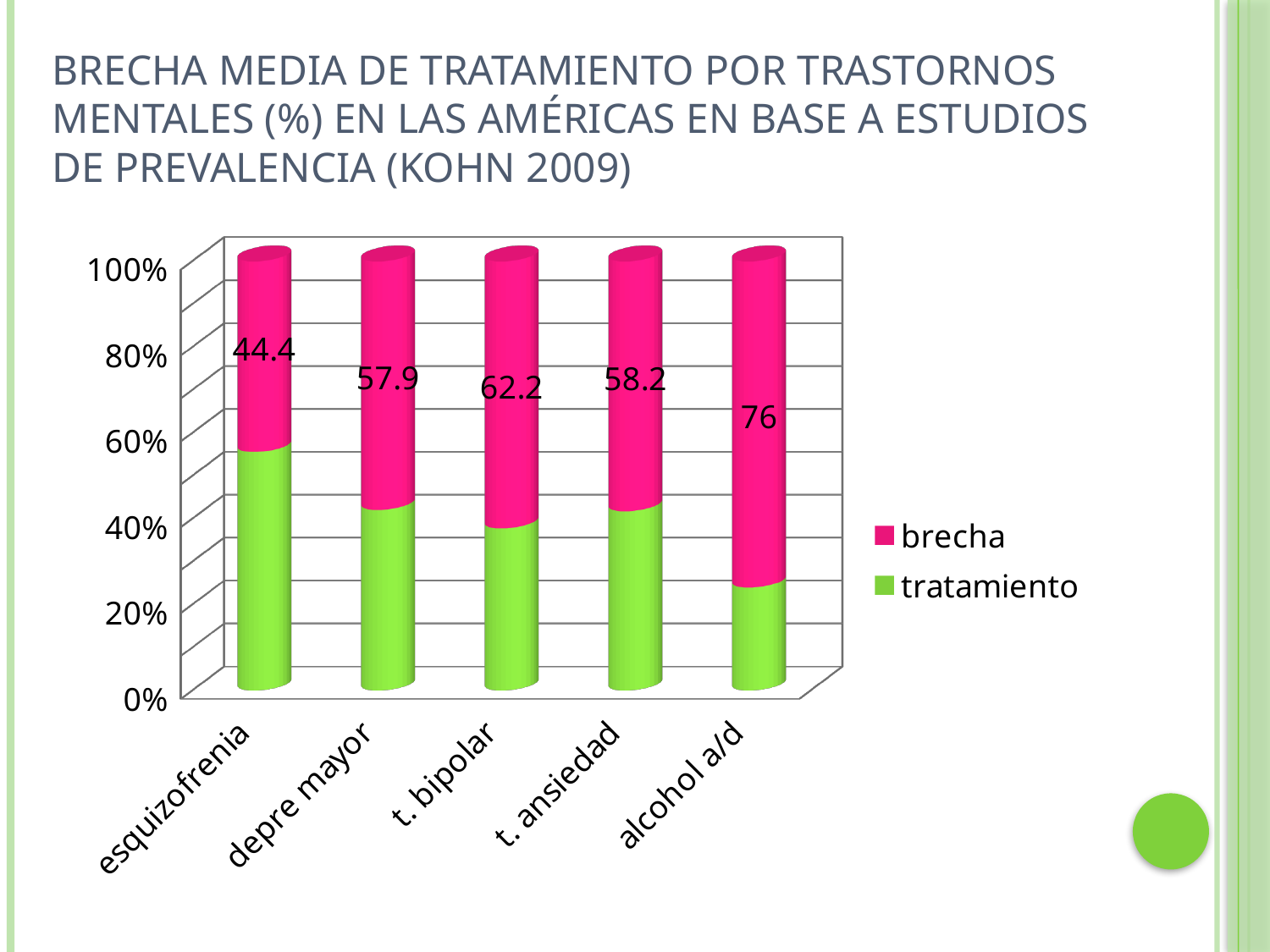
Which category has the highest brecha value? alcohol a/d How many categories are shown on the x axis? 5 What is the brecha value for t. bipolar? 62.2 What is the difference between the brecha values for alcohol a/d and esquizofrenia? 31.6 Which category has the lowest brecha value? esquizofrenia What kind of chart is shown on the slide? bar chart Is the tratamiento share for alcohol a/d greater or less than 40%? less What is the brecha value for depre mayor? 57.9 What is the brecha value for esquizofrenia? 44.4 Which has a larger brecha value, t. bipolar or t. ansiedad? t. bipolar How many series does the legend list? 2 What is the brecha value for alcohol a/d? 76